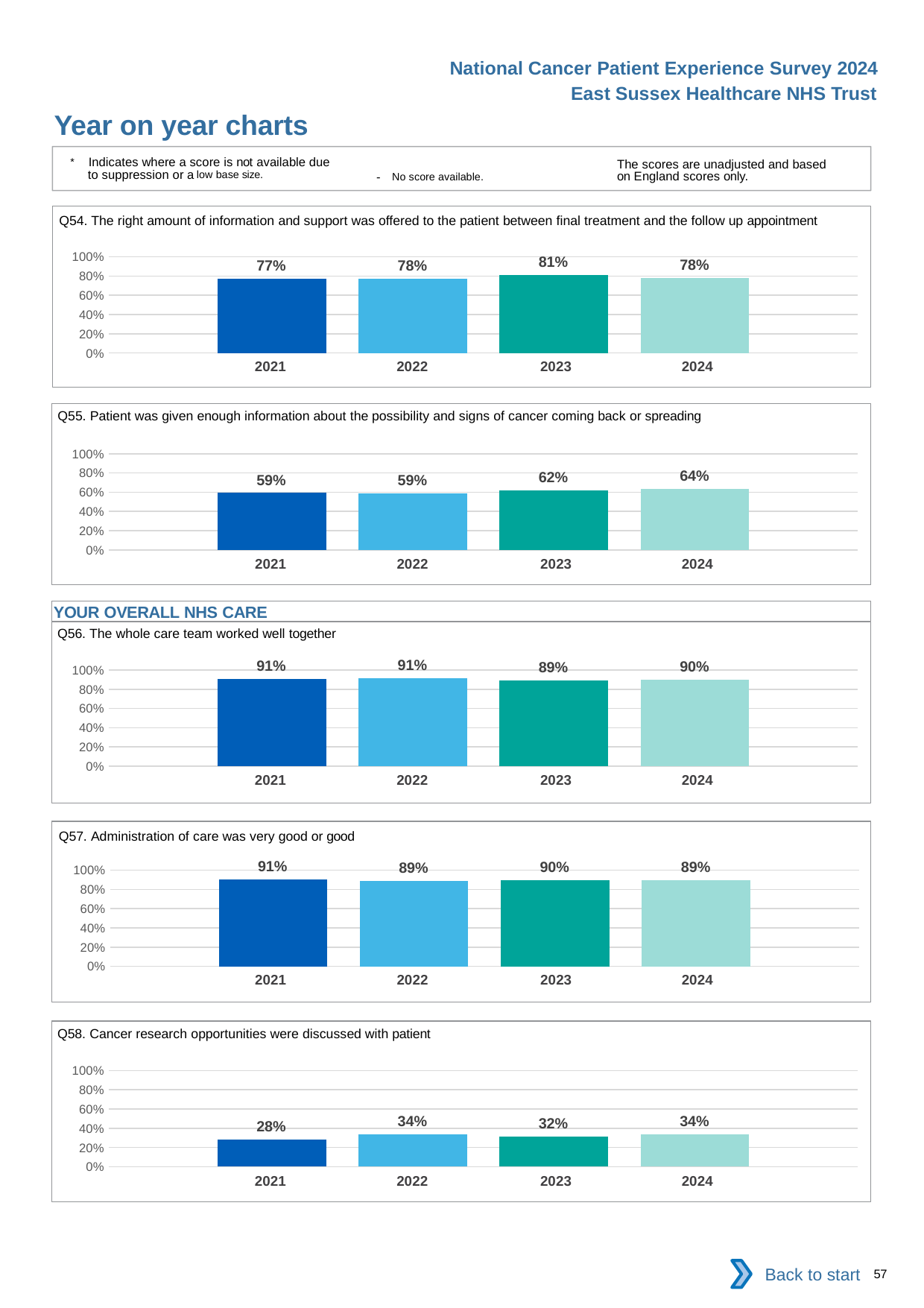
In the Q55 chart, do the values rise or fall from 2022 to 2024? rise How many years are shown in the Q57 chart? 4 In the Q55 chart, which year has the highest value? 2024 In the Q55 chart, what is the difference between the 2024 and 2021 values? 5% In the Q54 chart, what is the value for 2023? 81% In the Q58 chart, what is the difference between the 2022 and 2021 values? 6% What kind of chart is the Q56 chart? bar chart In the Q58 chart, is the value for 2024 greater or less than 40%? less In the Q58 chart, which year has the lowest value? 2021 In the Q56 chart, what is the value for 2023? 89% In the Q54 chart, is the value for 2022 greater or less than the value for 2023? less In the Q57 chart, which year has the highest value? 2021